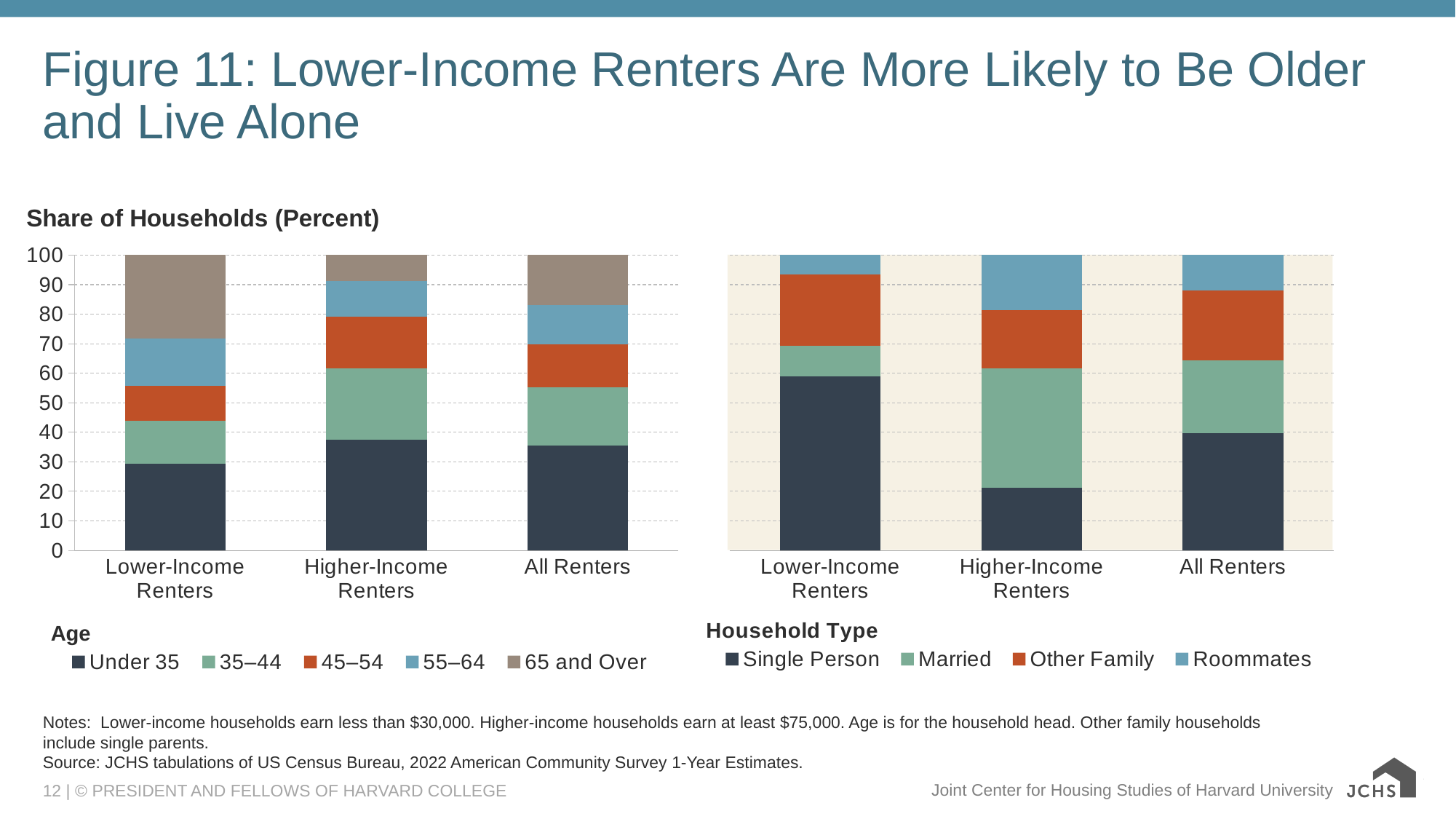
In the right chart (Household Type), which category has the largest Married segment? Higher-Income Renters How many categories are shown on the x axis of the left chart (Age)? 3 In the left chart (Age), which category has the largest 65 and Over segment? Lower-Income Renters In the left chart (Age), which category has the smallest 65 and Over segment? Higher-Income Renters In the right chart (Household Type), which category has the largest Single Person segment? Lower-Income Renters In the left chart (Age), is the Under 35 value for Lower-Income Renters greater or less than 40? less How many series does the Age legend list for the left chart? 5 In the left chart (Age), is the Under 35 value for Higher-Income Renters greater or less than 30? greater In the left chart (Age), which has the larger Under 35 share: Lower-Income Renters or Higher-Income Renters? Higher-Income Renters What kind of chart is the left chart (Age)? Stacked bar chart What is the axis label shown above the charts describing the measure plotted? Share of Households (Percent) How many series does the Household Type legend list for the right chart? 4